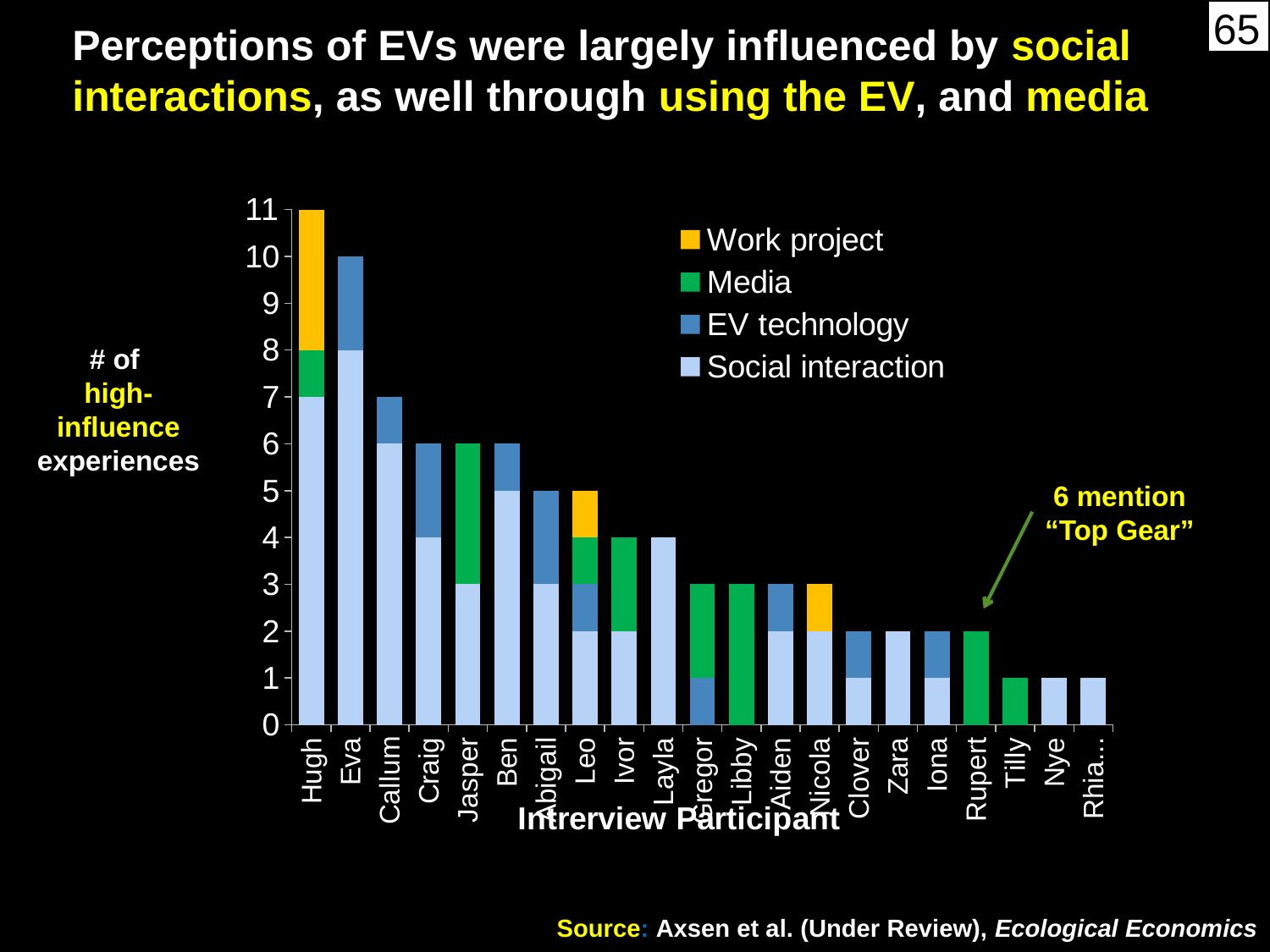
Which interview participant has the highest total number of high-influence experiences? Hugh What is the difference between the total bar heights for Hugh and Eva? 1 How many interview participants are shown on the x axis? 21 What kind of chart is shown on the slide? Stacked bar chart What is the total number of high-influence experiences for Eva? 10 Is the total value for Eva greater or less than 8? greater What is the title of the x axis? Interview Participant How many series does the legend list? 4 Which colour represents the Media series in the legend? Green What is the total number of high-influence experiences for Hugh? 11 Who has the larger total bar, Eva or Callum? Eva Do the total bar heights generally rise or fall moving from left to right along the x axis? Fall